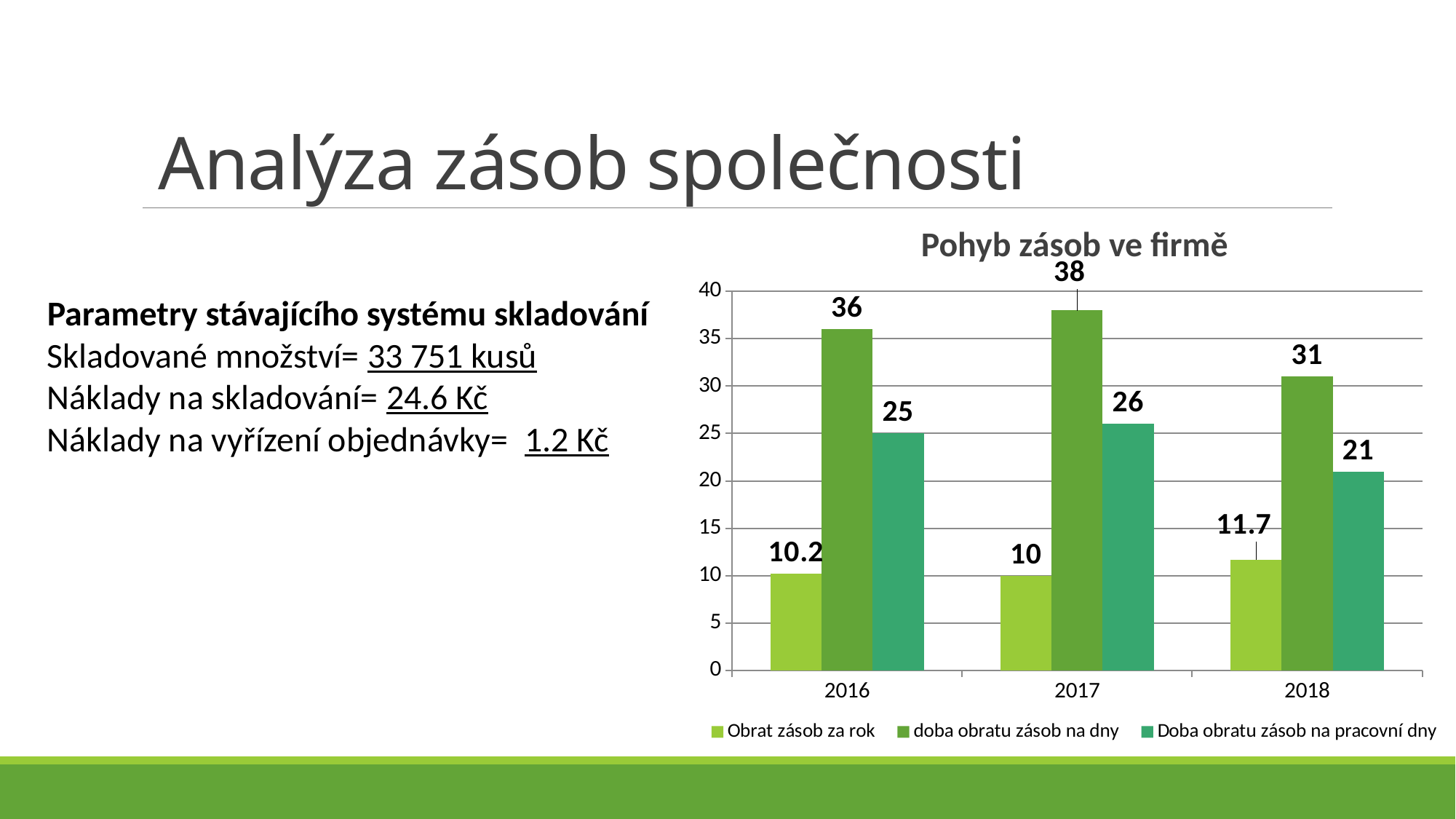
In which year is 'doba obratu zásob na dny' highest? 2017 How many series does the legend list? 3 Which is larger: 'Obrat zásob za rok' in 2018 or in 2017? 2018 What is the value of 'Doba obratu zásob na pracovní dny' for 2018? 21 What is the value of 'Obrat zásob za rok' for 2016? 10.2 What is the value of 'doba obratu zásob na dny' for 2017? 38 What is the title of the chart? Pohyb zásob ve firmě In which year is 'Doba obratu zásob na pracovní dny' lowest? 2018 What is the difference between 'doba obratu zásob na dny' and 'Doba obratu zásob na pracovní dny' in 2016? 11 Is the value of 'doba obratu zásob na dny' for 2018 greater or less than 35? less How many years are shown on the x axis? 3 What kind of chart is shown on the slide? bar chart